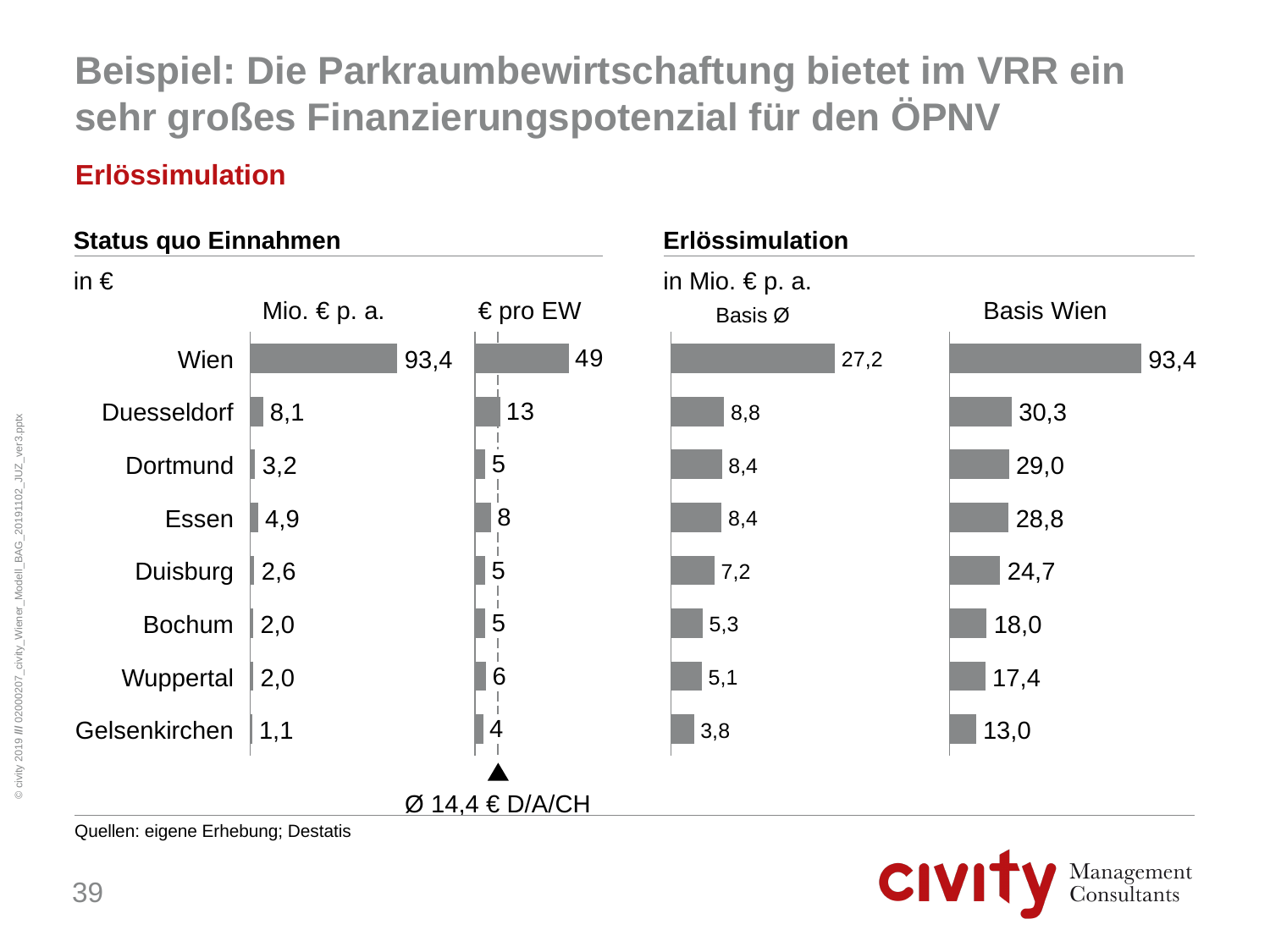
In the 'Mio. € p. a.' chart under Status quo Einnahmen, what is the value for Duesseldorf? 8,1 In the '€ pro EW' chart under Status quo Einnahmen, what is the value for Wien? 49 In the 'Mio. € p. a.' chart under Status quo Einnahmen, which city has the highest value? Wien In the '€ pro EW' chart under Status quo Einnahmen, what average value is marked by the dashed line? Ø 14,4 € D/A/CH In the 'Basis Wien' chart under Erlössimulation, what is the value for Essen? 28,8 In the 'Basis Wien' chart under Erlössimulation, is the value for Bochum or Wuppertal larger? Bochum In the 'Basis Ø' chart under Erlössimulation, what is the value for Duisburg? 7,2 What kind of chart is the 'Basis Wien' chart under Erlössimulation? Bar chart In the 'Mio. € p. a.' chart under Status quo Einnahmen, what is the difference between the values for Essen and Dortmund? 1,7 How many cities are shown in the 'Basis Ø' chart under Erlössimulation? 8 In the 'Basis Ø' chart under Erlössimulation, what is the difference between the values for Wien and Duesseldorf? 18,4 In the 'Basis Wien' chart under Erlössimulation, which city has the lowest value? Gelsenkirchen